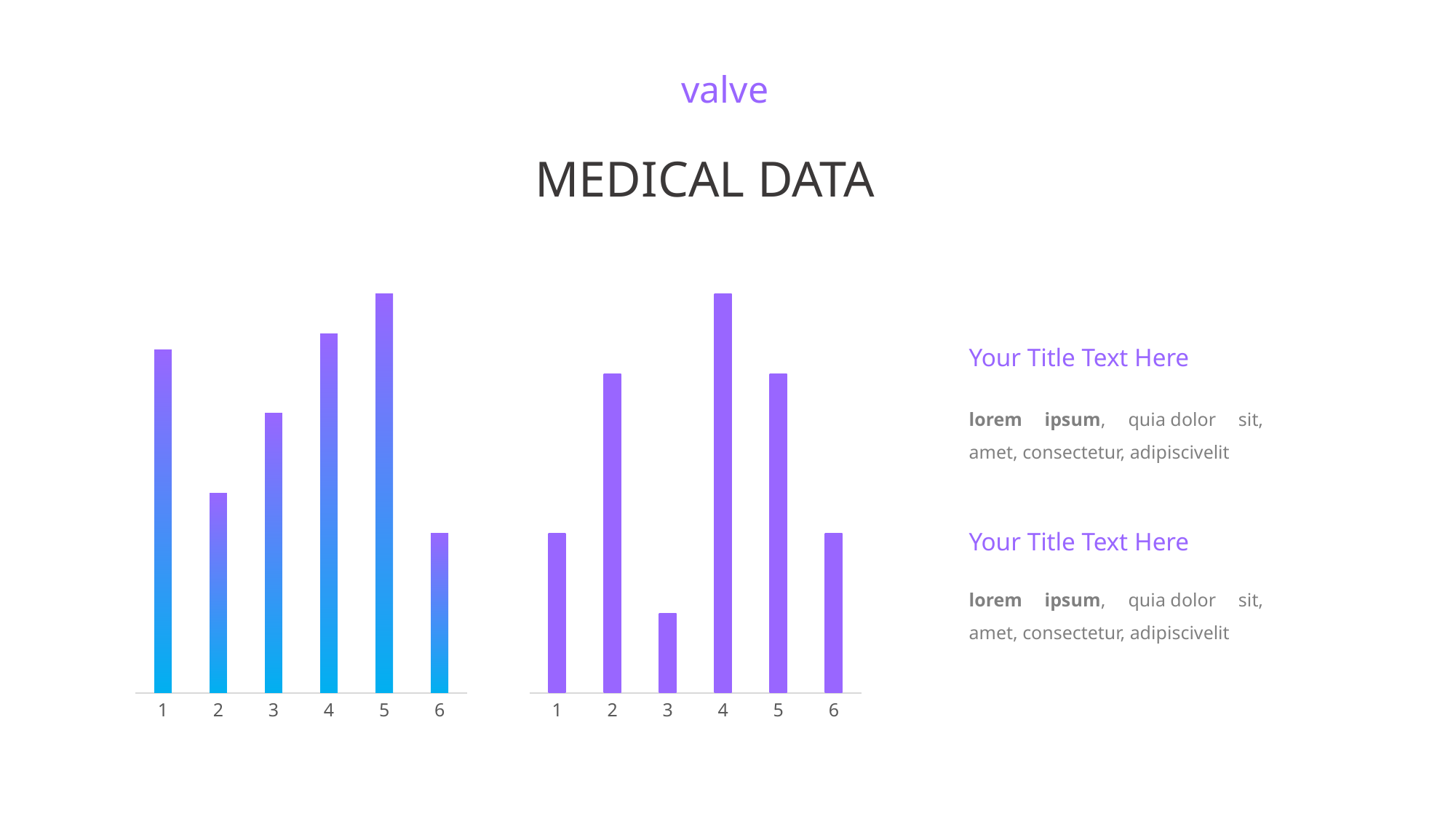
On the right chart, which category has the shortest bar? 3 What type of chart is the left chart? Bar chart On the left chart, which category has the tallest bar? 5 How many categories are shown on the right chart? 6 How many charts are shown on the slide? 2 On the left chart, which bar is taller, category 2 or category 3? 3 How many categories are shown on the left chart? 6 On the left chart, which bar is taller, category 4 or category 5? 5 On the left chart, which category has the shortest bar? 6 On the right chart, which bar is taller, category 3 or category 6? 6 On the right chart, which category has the tallest bar? 4